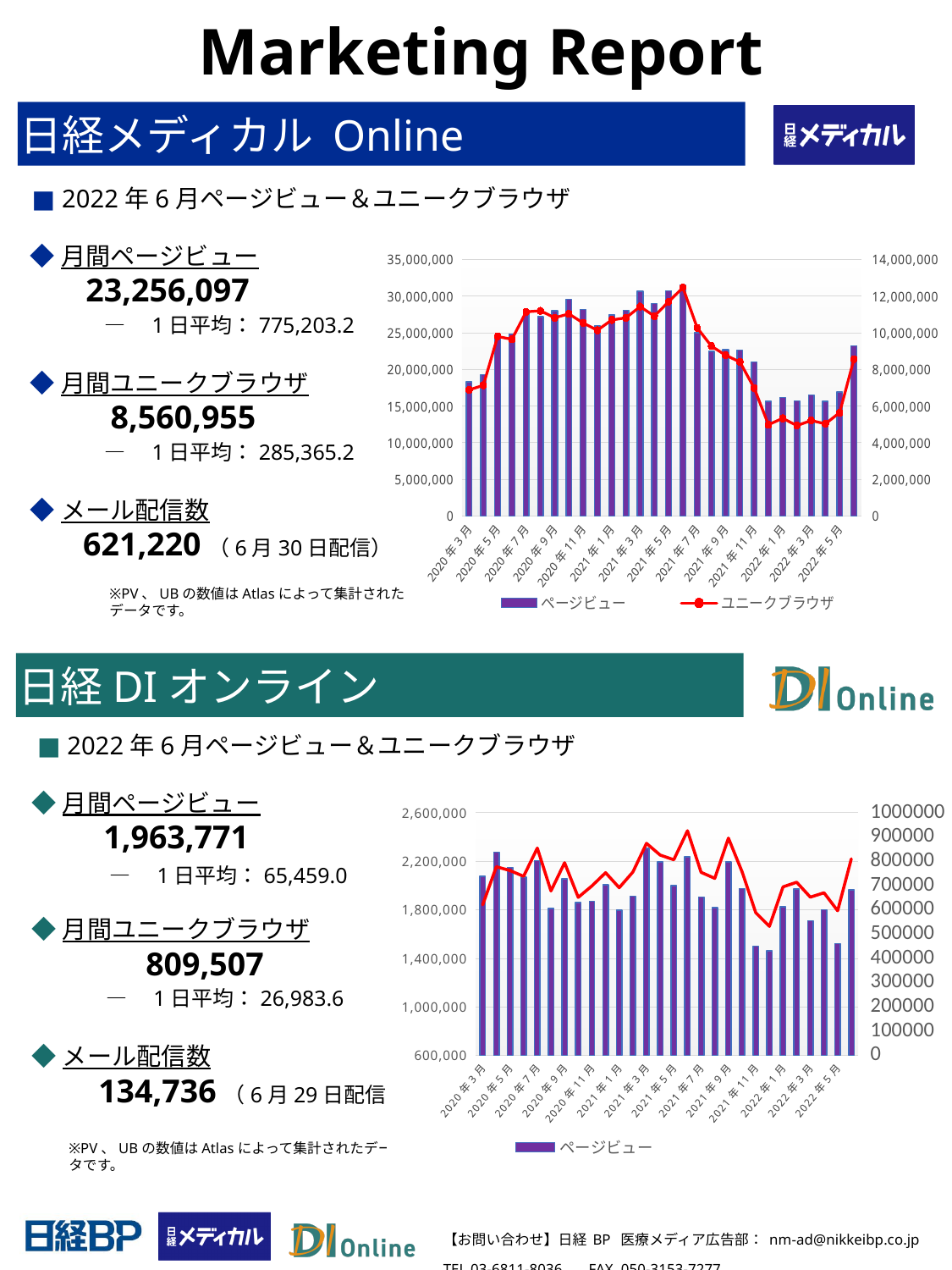
What is the lowest value shown on the left axis of the 日経DIオンライン chart? 600,000 In the 日経メディカル Online chart, do the ページビュー bars rise or fall from 2021年7月 to 2022年1月? fall How many series does the legend of the 日経メディカル Online chart list? 2 What kind of chart is shown in the 日経メディカル Online section? A combined bar and line chart How many series does the legend of the 日経DIオンライン chart list? 1 In the 日経DIオンライン chart, which has the larger ページビュー value, 2020年5月 or 2022年1月? 2020年5月 In the 日経メディカル Online chart, is the ページビュー value for 2020年3月 greater or less than 15,000,000? greater In the 日経メディカル Online chart, which has the larger ページビュー value, 2020年3月 or 2021年5月? 2021年5月 In the 日経メディカル Online chart, is the ページビュー value for 2022年1月 greater or less than 20,000,000? less In the 日経メディカル Online chart, which series is drawn as a red line? ユニークブラウザ In the 日経メディカル Online chart, is the ユニークブラウザ value for 2022年1月 greater or less than 6,000,000 on the right axis? less